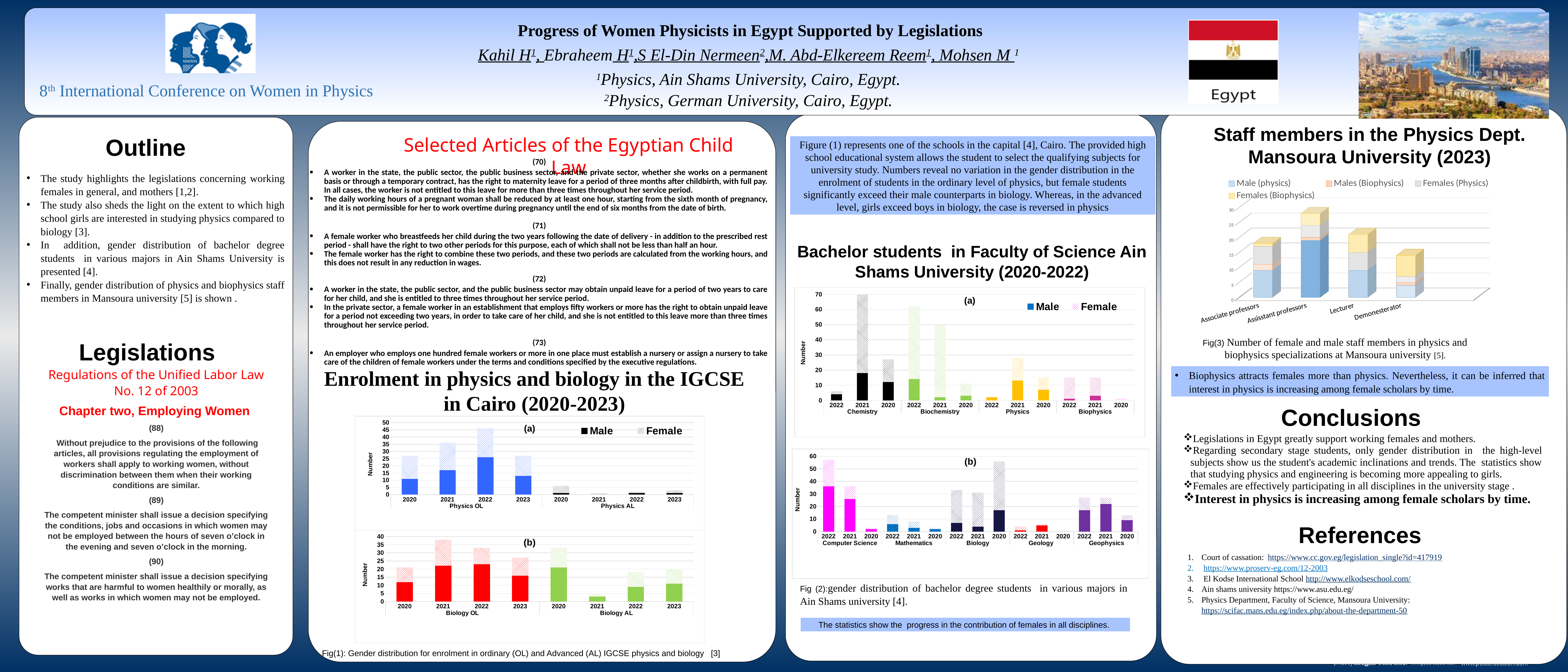
In Fig(2)(b), the Bachelor students chart for Computer Science, Mathematics, Biology, Geology and Geophysics, is the total bar for Computer Science 2022 greater or less than 50? greater In Fig(1)(a), the physics IGCSE enrolment chart, which year has the tallest Physics OL bar? 2022 In Fig(3), the Mansoura University staff members chart, how many series does the legend list? 4 In Fig(1)(a), the physics IGCSE enrolment chart, how many series does the legend list? 2 In Fig(1)(b), the biology IGCSE enrolment chart, which year has the tallest Biology OL bar? 2021 In Fig(1)(b), the biology IGCSE enrolment chart, which is larger: the Biology OL bar for 2021 or the Biology AL bar for 2021? Biology OL 2021 In Fig(2)(a), the Bachelor students chart for Chemistry, Biochemistry, Physics and Biophysics, which major and year has the tallest bar? Chemistry 2021 What kind of chart is Fig(3), the Mansoura University staff members chart? bar chart In Fig(2)(a), the Bachelor students chart, is the total bar for Chemistry 2021 greater or less than 60? greater In Fig(1)(a), the physics IGCSE enrolment chart, is the total Physics OL bar for 2022 greater or less than 40? greater